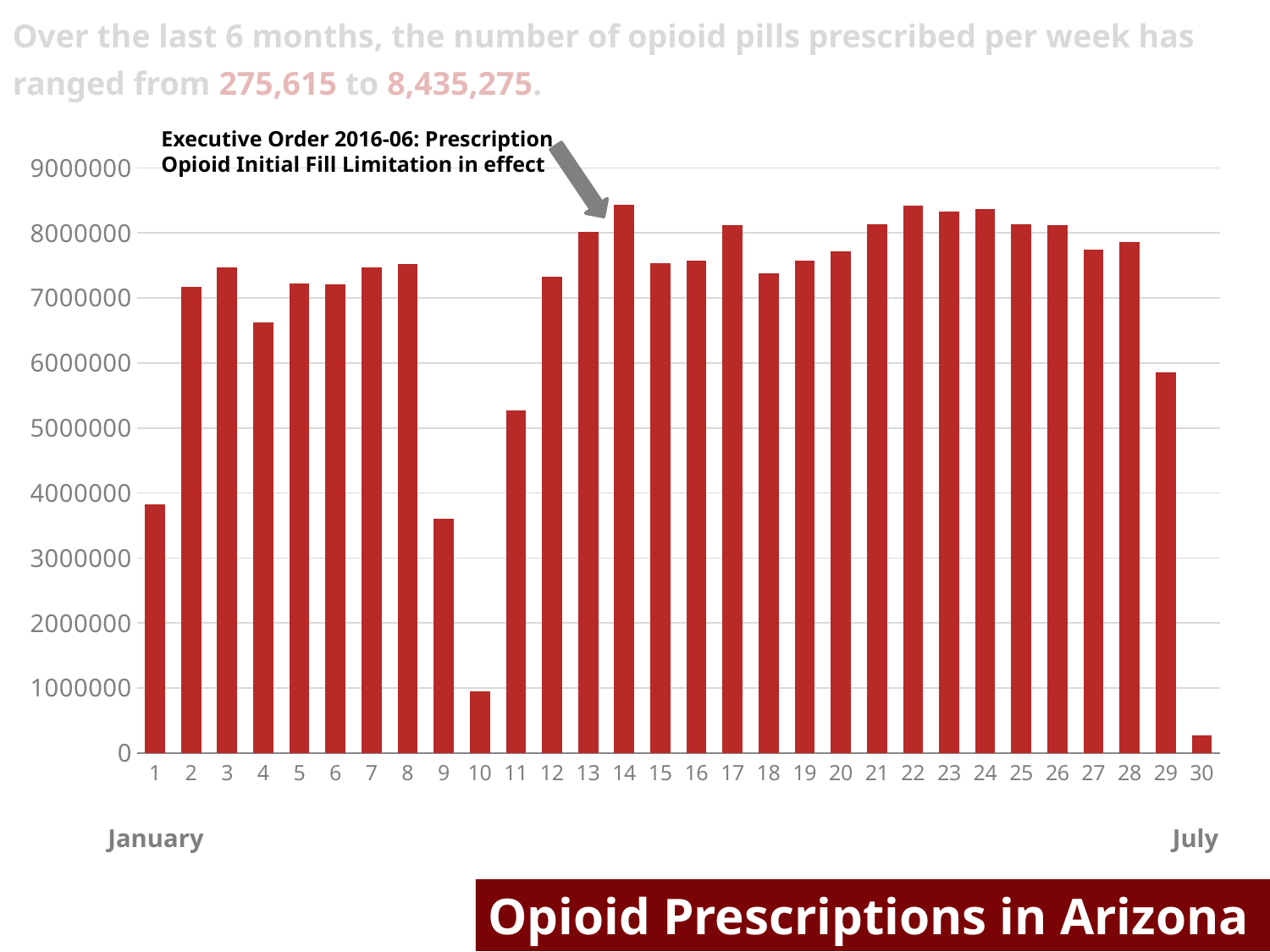
According to the slide text, what is the lowest weekly number of opioid pills prescribed? 275,615 What is the title of the chart shown in the red banner? Opioid Prescriptions in Arizona Is the value for week 14 greater or less than 8000000? greater Which week has the larger value, week 10 or week 11? 11 According to the slide text, what is the highest weekly number of opioid pills prescribed? 8,435,275 Is the value for week 11 greater or less than 5000000? greater Which week has the lowest number of opioid pills prescribed? 30 How many weeks (bars) are plotted on the chart? 30 Is the value for week 1 greater or less than 4000000? less What kind of chart is shown on the slide? bar chart Do the values rise or fall from week 27 to week 30? fall